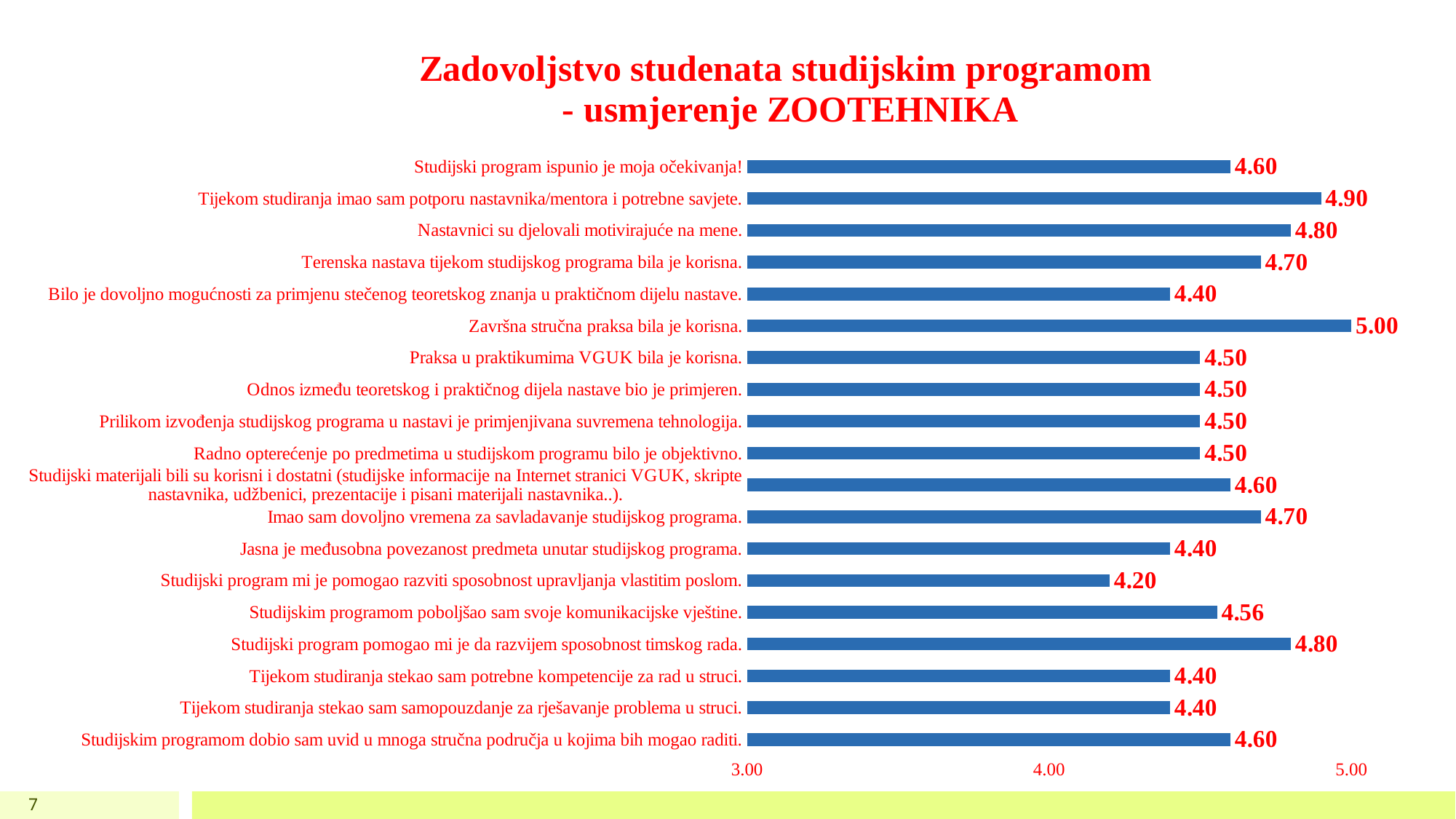
What is the value for "Studijskim programom poboljšao sam svoje komunikacijske vještine."? 4.56 What is the difference between the values for "Studijski program pomogao mi je da razvijem sposobnost timskog rada." and "Studijskim programom poboljšao sam svoje komunikacijske vještine."? 0.24 Which statement has the lowest value? Studijski program mi je pomogao razviti sposobnost upravljanja vlastitim poslom. What kind of chart is shown on the slide? bar chart What is the difference between the values for "Završna stručna praksa bila je korisna." and "Studijski program mi je pomogao razviti sposobnost upravljanja vlastitim poslom."? 0.80 How many statements (bars) are shown in the chart? 19 Which is larger: the value for "Nastavnici su djelovali motivirajuće na mene." or the value for "Terenska nastava tijekom studijskog programa bila je korisna."? Nastavnici su djelovali motivirajuće na mene. What is the title of the chart? Zadovoljstvo studenata studijskim programom - usmjerenje ZOOTEHNIKA What is the value for "Završna stručna praksa bila je korisna."? 5.00 Which statement has the highest value? Završna stručna praksa bila je korisna. What is the value for "Tijekom studiranja imao sam potporu nastavnika/mentora i potrebne savjete."? 4.90 What is the value for "Jasna je međusobna povezanost predmeta unutar studijskog programa."? 4.40